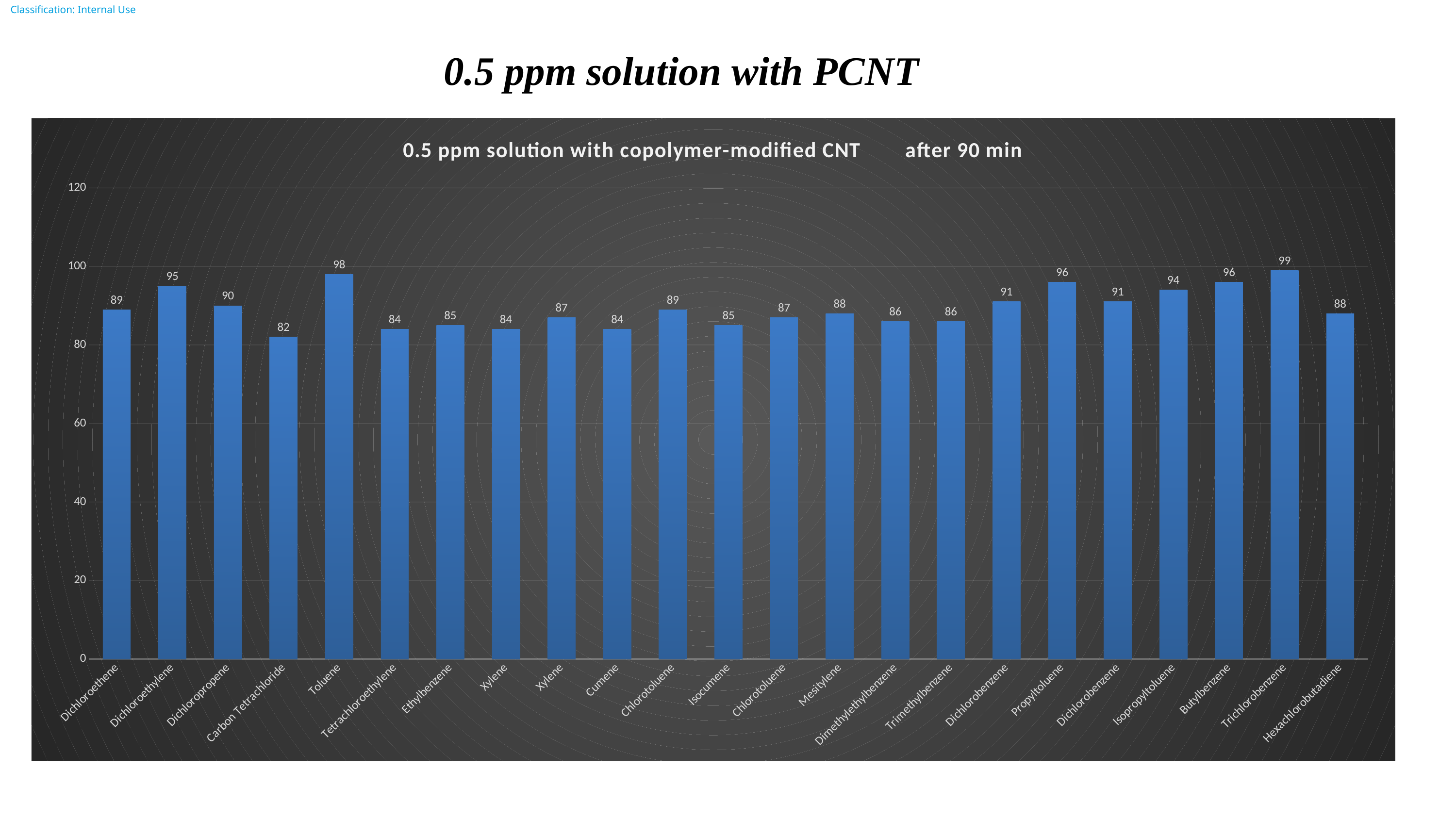
What is the difference between the values for Toluene and Carbon Tetrachloride? 16 Which category has the lowest value? Carbon Tetrachloride Which category has the highest value? Trichlorobenzene What is the value for Propyltoluene? 96 How many bars are plotted in the chart? 23 What is the value for Hexachlorobutadiene? 88 Which is larger, the value for Dichloroethylene or the value for Isopropyltoluene? Dichloroethylene What is the value for Carbon Tetrachloride? 82 What is the difference between the values for Trichlorobenzene and Mesitylene? 11 What is the value for Toluene? 98 What is the title printed inside the chart area? 0.5 ppm solution with copolymer-modified CNT after 90 min What kind of chart is shown on the slide? Bar chart